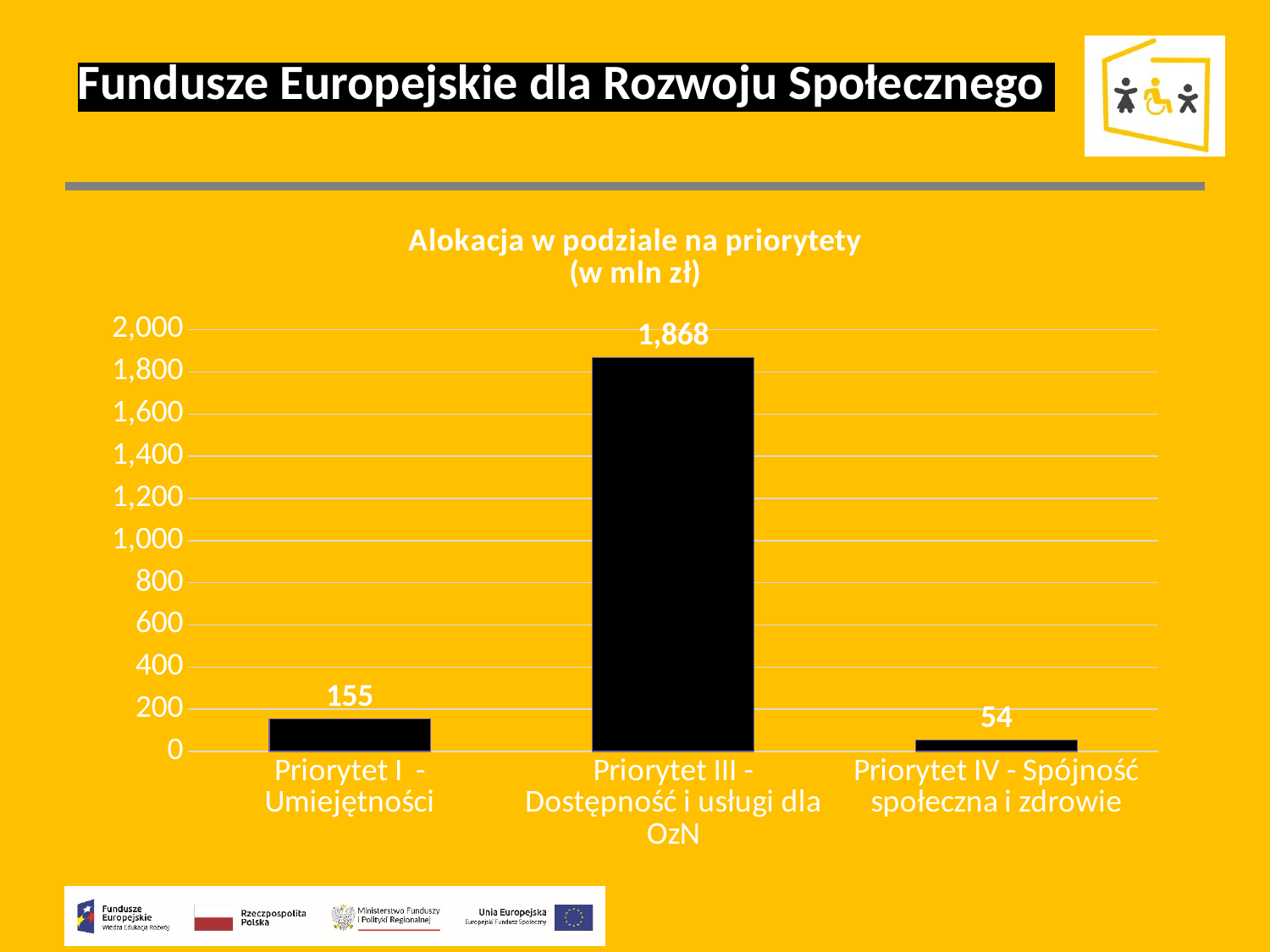
Which is larger, the value for Priorytet I or the value for Priorytet IV? Priorytet I What is the title of the chart? Alokacja w podziale na priorytety (w mln zł) What is the difference between the values for Priorytet III and Priorytet I? 1,713 What is the difference between the values for Priorytet I and Priorytet IV? 101 What is the value for Priorytet IV - Spójność społeczna i zdrowie? 54 What is the value for Priorytet I - Umiejętności? 155 Which priority has the lowest allocation? Priorytet IV - Spójność społeczna i zdrowie Which priority has the highest allocation? Priorytet III - Dostępność i usługi dla OzN Is the value for Priorytet III greater or less than 1,800? greater How many categories are shown in the chart? 3 What is the value for Priorytet III - Dostępność i usługi dla OzN? 1,868 What kind of chart is shown on the slide? bar chart